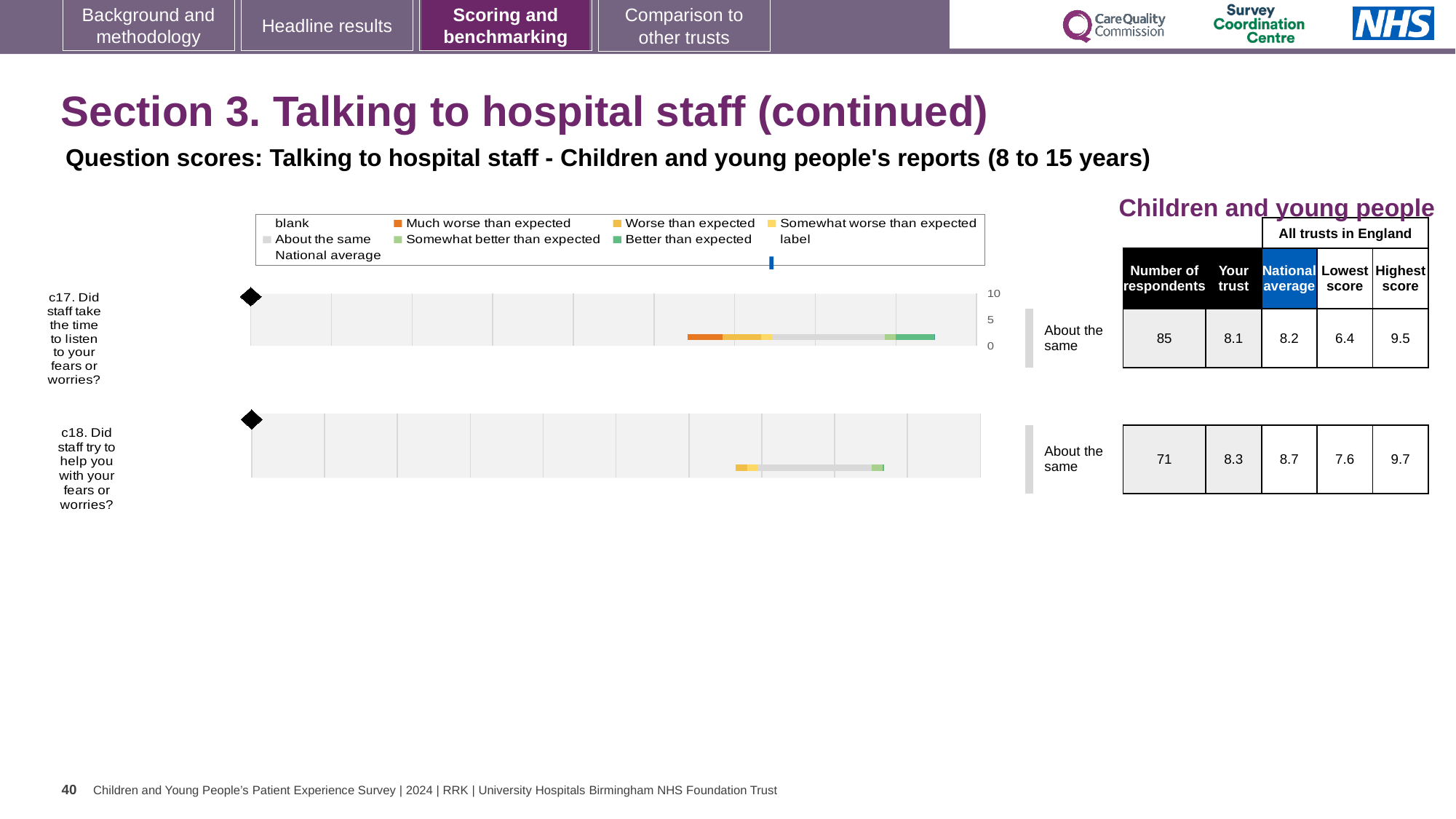
What kind of chart is used to show the question scores for c17 and c18? bar chart What is the national average score for c18 (Did staff try to help you with your fears or worries?)? 8.7 Which question has the higher trust score, c17 or c18? c18 What is the lowest score among all trusts in England for c17? 6.4 Which question has more respondents, c17 or c18? c17 What is the trust's score for c17 (Did staff take the time to listen to your fears or worries?)? 8.1 What colour in the legend represents 'Much worse than expected'? Orange What benchmark category is the trust's score for c17 placed in? About the same How many respondents answered c17? 85 What is the highest score among all trusts in England for c18? 9.7 What is the difference between the national average and the trust's score for c18? 0.4 How many questions (c17 and c18) are plotted on the slide? 2